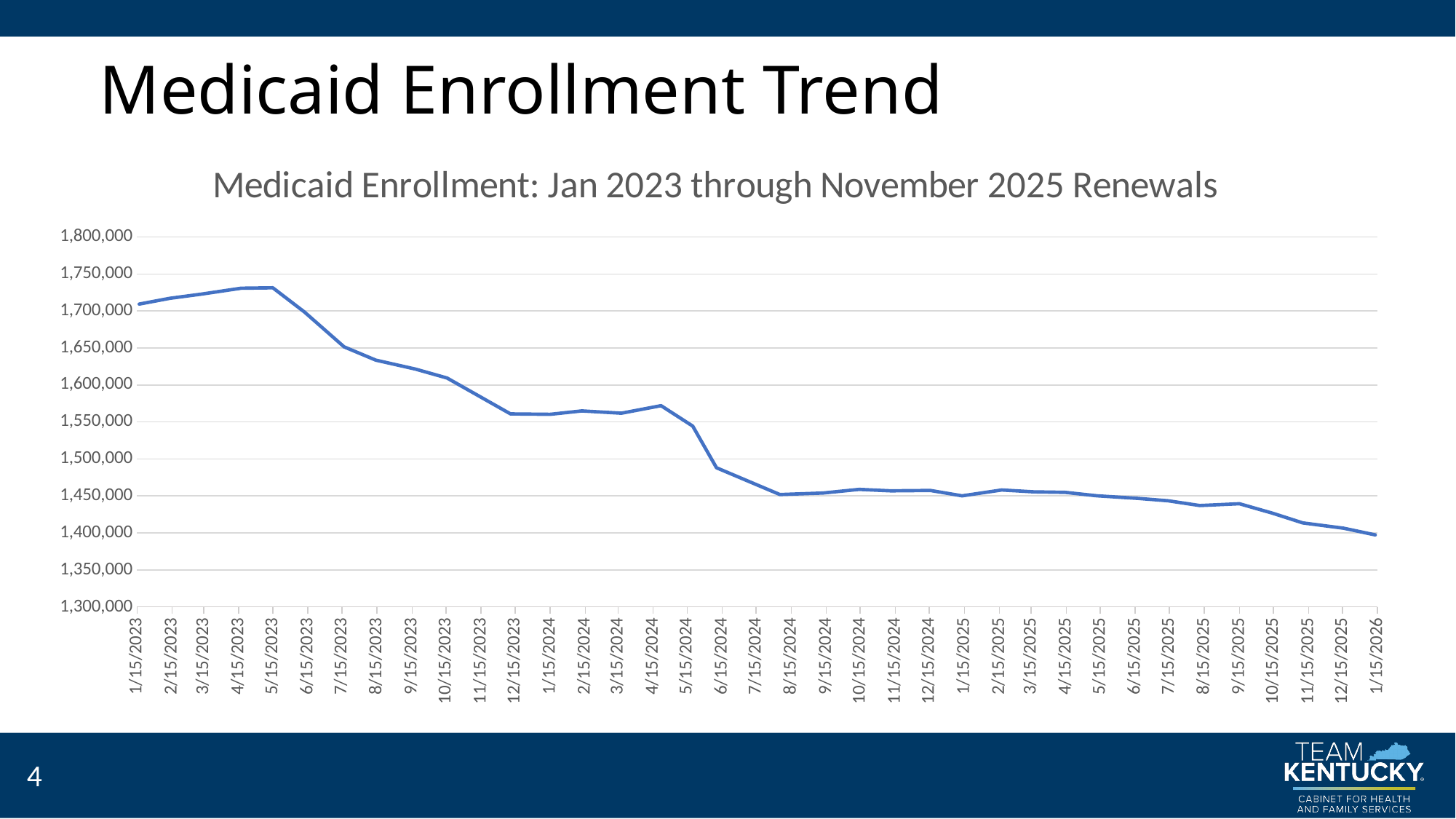
Is the value for 12/15/2023 greater or less than 1,600,000? less Which is larger, the value for 4/15/2024 or the value for 6/15/2024? 4/15/2024 Is the value for 6/15/2024 greater or less than 1,500,000? less What is the lowest value shown on the y axis? 1,300,000 What kind of chart is shown on the slide? line chart Overall, do the enrollment values rise or fall from 1/15/2023 to 1/15/2026? fall Is the value for 6/15/2023 greater or less than 1,650,000? greater Which is larger, the value for 1/15/2023 or the value for 1/15/2026? 1/15/2023 What is the title of the chart? Medicaid Enrollment: Jan 2023 through November 2025 Renewals Which date has the lowest enrollment value? 1/15/2026